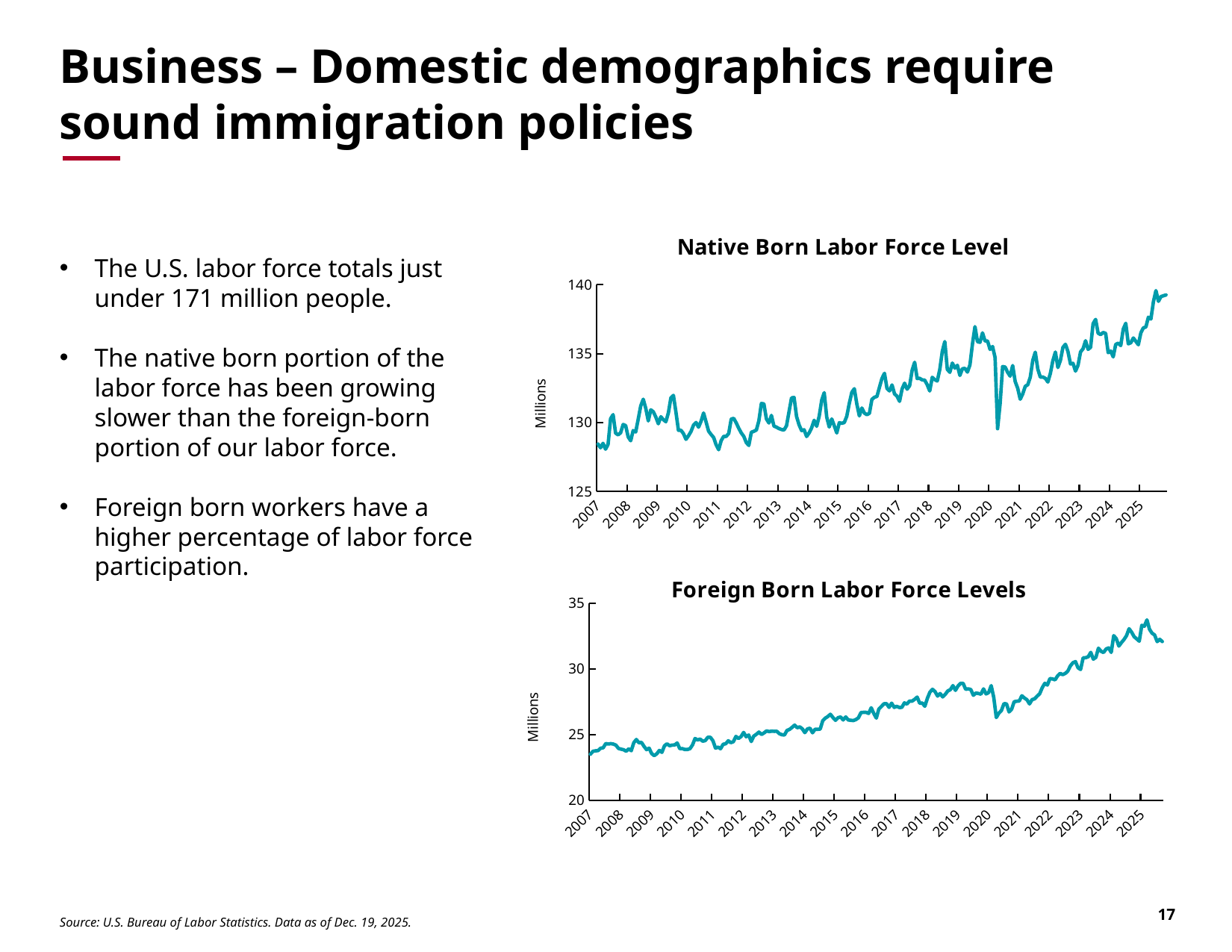
What is the y-axis label on the 'Native Born Labor Force Level' chart? Millions In the 'Foreign Born Labor Force Levels' chart, is the value at the start of 2007 greater or less than 25? less In the 'Foreign Born Labor Force Levels' chart, do values generally rise or fall from 2007 to 2025? rise In the 'Native Born Labor Force Level' chart, is the value at the start of 2007 greater or less than 130? less In the 'Native Born Labor Force Level' chart, is the value at the end of 2025 greater or less than 135? greater What kind of chart is the 'Foreign Born Labor Force Levels' chart? line chart In the 'Native Born Labor Force Level' chart, do values generally rise or fall from 2007 to 2025? rise What is the title of the lower chart on the slide? Foreign Born Labor Force Levels What kind of chart is the 'Native Born Labor Force Level' chart? line chart How many charts are shown on the slide? 2